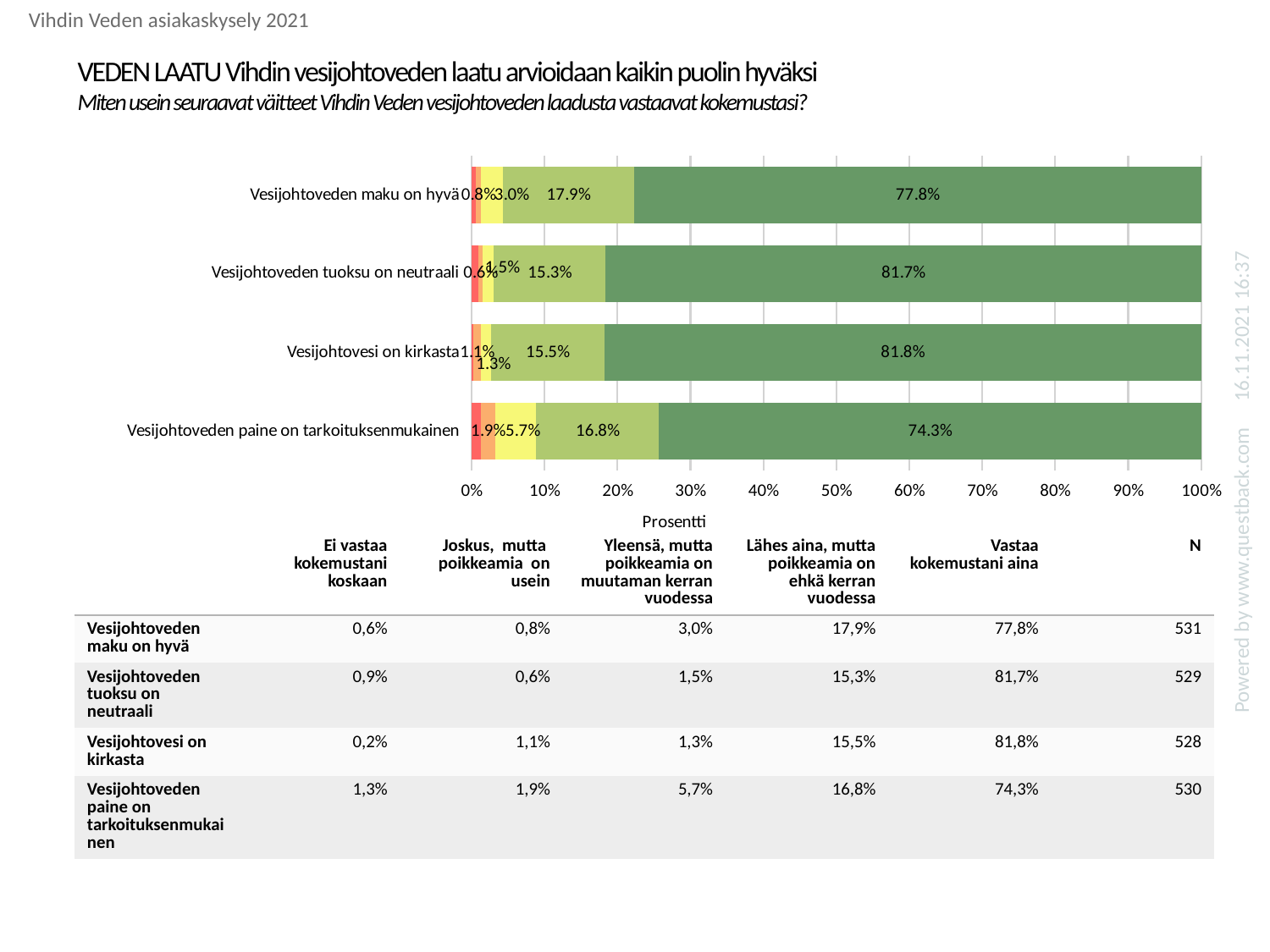
What is the difference in percentage points between the "Vastaa kokemustani aina" values for "Vesijohtoveden tuoksu on neutraali" and "Vesijohtoveden maku on hyvä"? 3.9 percentage points Is the "Vastaa kokemustani aina" value for "Vesijohtoveden paine on tarkoituksenmukainen" greater or less than 70%? greater Which statement has the lowest "Vastaa kokemustani aina" share? Vesijohtoveden paine on tarkoituksenmukainen How many statements (bars) are shown in the chart? 4 Which is larger: the "Lähes aina, mutta poikkeamia on ehkä kerran vuodessa" value for "Vesijohtoveden maku on hyvä" or for "Vesijohtoveden paine on tarkoituksenmukainen"? Vesijohtoveden maku on hyvä What is the "Vastaa kokemustani aina" value for "Vesijohtoveden tuoksu on neutraali"? 81.7% What is the "Yleensä, mutta poikkeamia on muutaman kerran vuodessa" value for "Vesijohtoveden paine on tarkoituksenmukainen"? 5.7% What is the "Lähes aina, mutta poikkeamia on ehkä kerran vuodessa" value for "Vesijohtoveden paine on tarkoituksenmukainen"? 16.8% What percentage of respondents answered "Vastaa kokemustani aina" for "Vesijohtoveden maku on hyvä"? 77.8% Which statement has the highest "Lähes aina, mutta poikkeamia on ehkä kerran vuodessa" share? Vesijohtoveden maku on hyvä What is the title of the chart's horizontal axis? Prosentti What type of chart is shown on the slide? Stacked bar chart